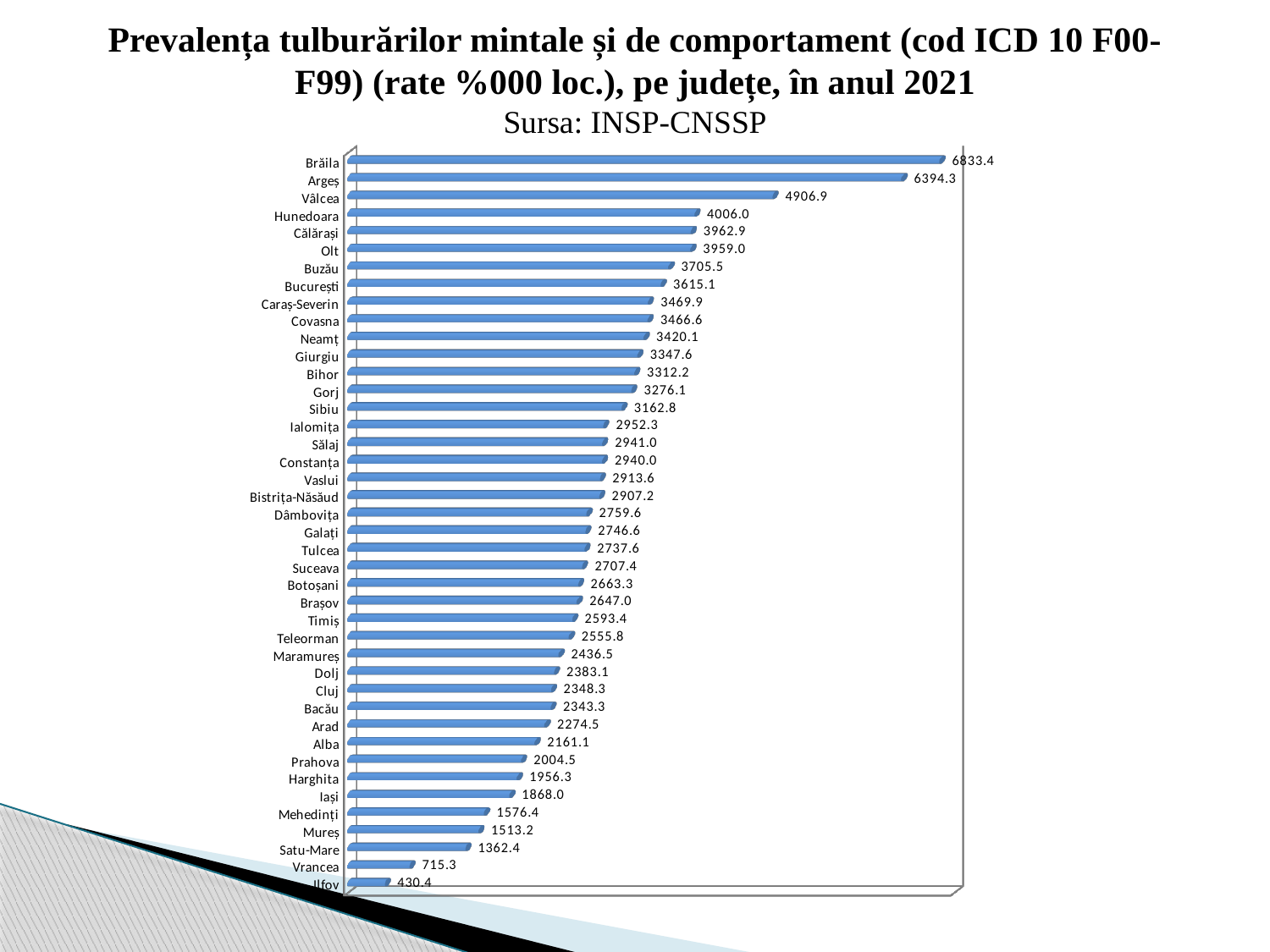
Which has a higher prevalence rate, Hunedoara or Olt? Hunedoara What is the prevalence rate for Vrancea? 715.3 What is the prevalence rate for București? 3615.1 What is the source of the data cited on the slide? INSP-CNSSP What is the prevalence rate for Argeș? 6394.3 What type of chart is shown on the slide? bar chart What is the prevalence rate for Vâlcea? 4906.9 How many counties are shown in the chart? 42 What is the difference between the prevalence rates of Brăila and Argeș? 439.1 Which county has the lowest prevalence rate? Ilfov What is the prevalence rate for Cluj? 2348.3 Which county has the highest prevalence rate? Brăila